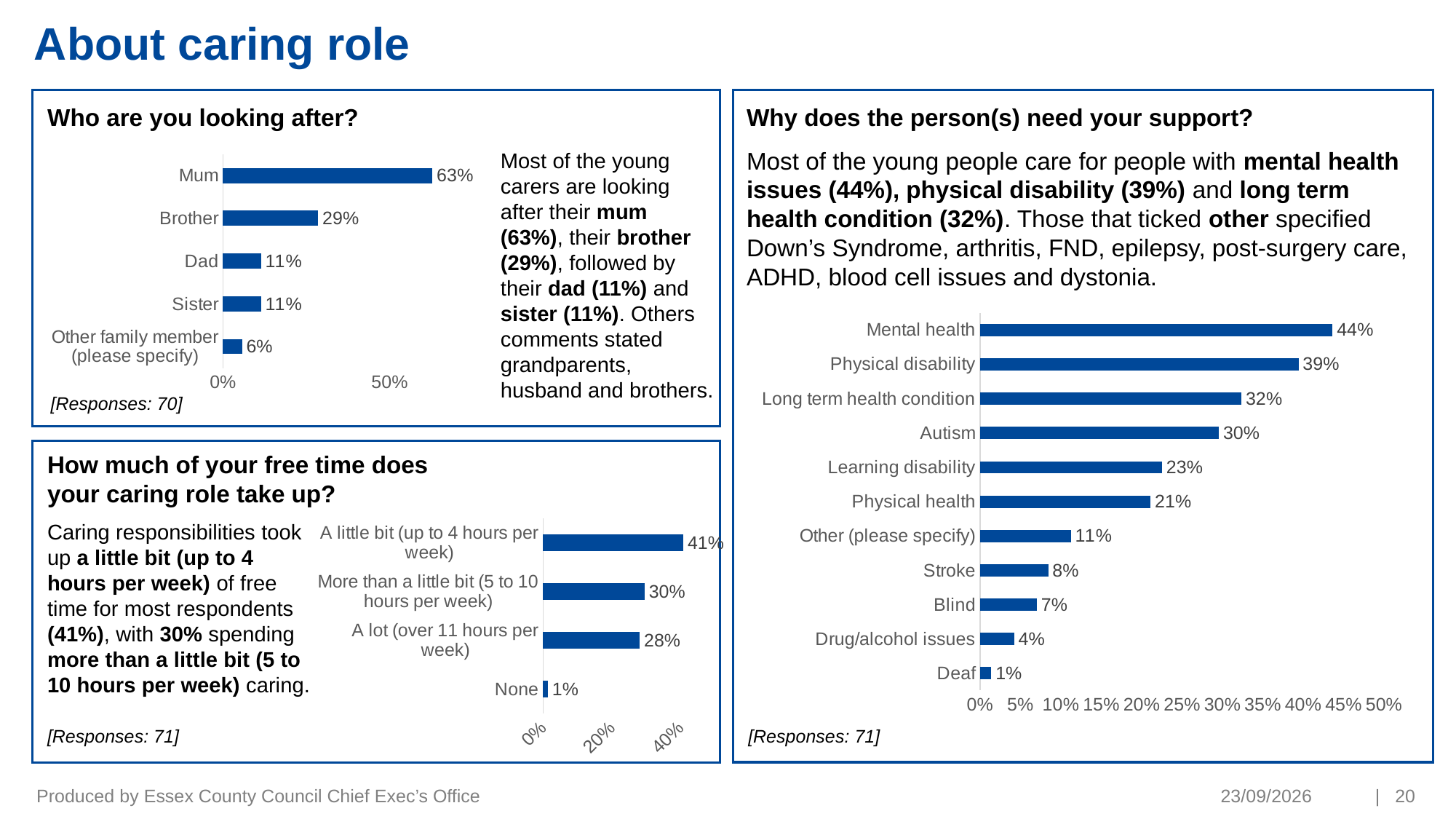
In the 'How much of your free time does your caring role take up?' chart, which category has the highest value? A little bit (up to 4 hours per week) In the 'Why does the person(s) need your support?' chart, what is the value for Autism? 30% How many categories are shown in the 'Who are you looking after?' chart? 5 In the 'Why does the person(s) need your support?' chart, which category has the highest value? Mental health In the 'Why does the person(s) need your support?' chart, which is larger, Learning disability or Physical health? Learning disability In the 'How much of your free time does your caring role take up?' chart, is the value for 'More than a little bit (5 to 10 hours per week)' greater or less than 20%? greater In the 'Who are you looking after?' chart, which category has the lowest value? Other family member (please specify) In the 'Who are you looking after?' chart, what is the difference between the values for Mum and Brother? 34% How many categories are shown in the 'Why does the person(s) need your support?' chart? 11 In the 'How much of your free time does your caring role take up?' chart, what is the value for 'A lot (over 11 hours per week)'? 28% What type of chart is used in the 'Why does the person(s) need your support?' panel? Bar chart In the 'Who are you looking after?' chart, what is the value for Mum? 63%